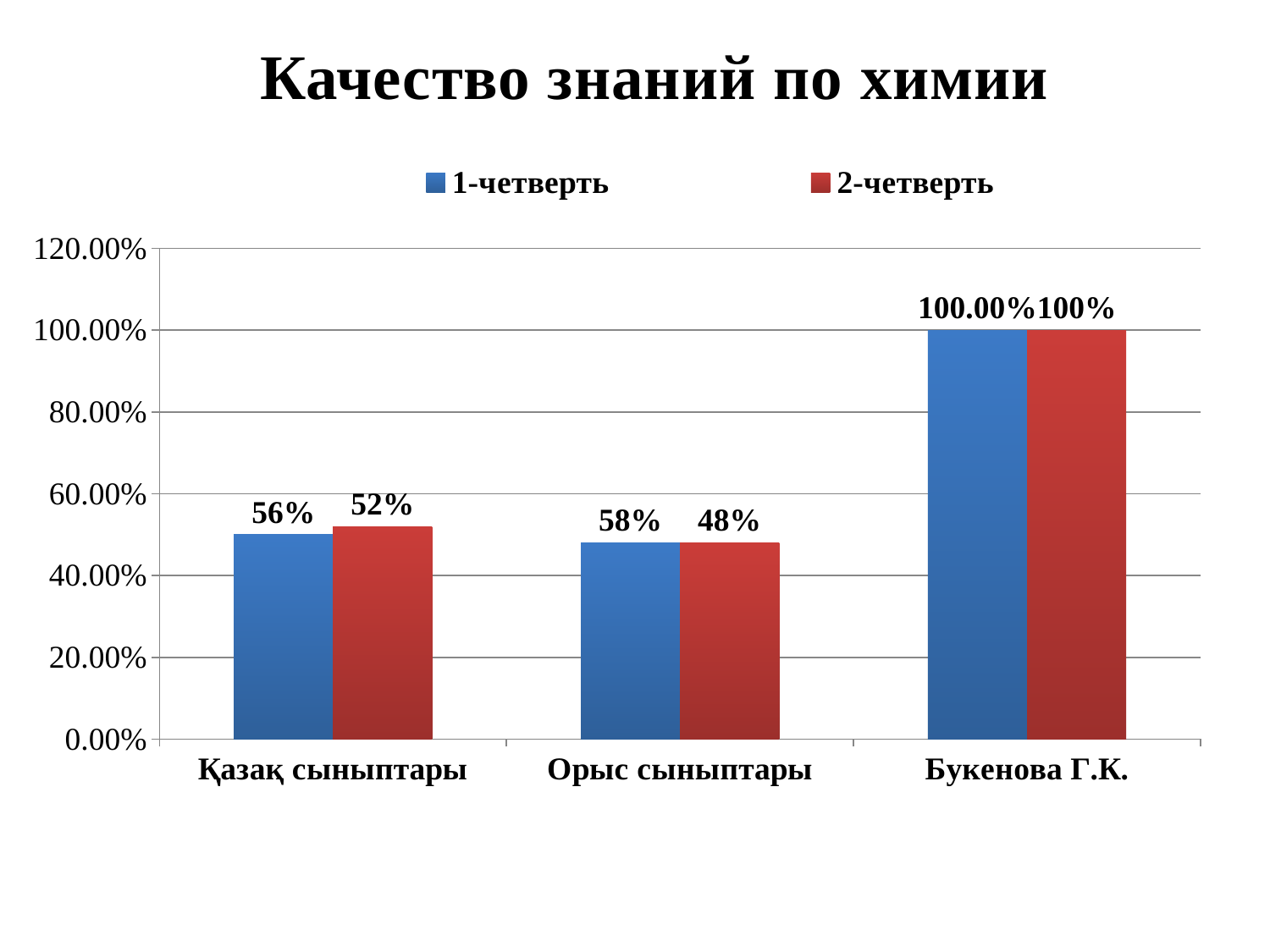
What is the value for Букенова Г.К. in the 1-четверть series? 100.00% What is the value for Қазақ сыныптары in the 1-четверть series? 56% How many categories are shown on the x axis? 3 What is the value for Қазақ сыныптары in the 2-четверть series? 52% Which category has the lowest value in the 2-четверть series? Орыс сыныптары What is the value for Орыс сыныптары in the 2-четверть series? 48% Which category has the highest value in the 2-четверть series? Букенова Г.К. Is the 1-четверть value for Букенова Г.К. greater or less than 80.00%? greater How many series does the legend list? 2 What kind of chart is shown on the slide? bar chart What is the title of the chart? Качество знаний по химии What is the difference between the 2-четверть values for Қазақ сыныптары and Орыс сыныптары? 4%